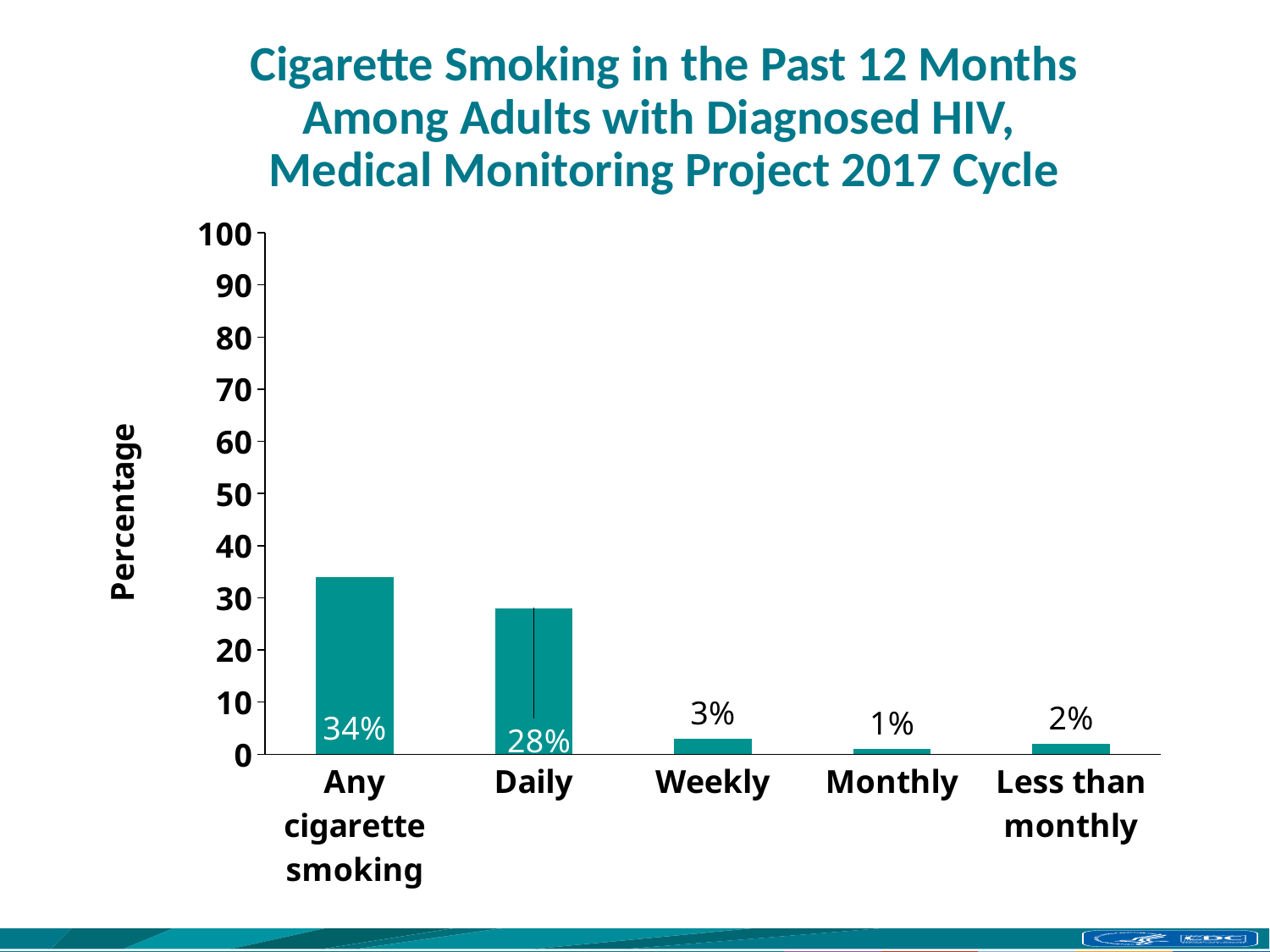
What is the difference in percentage points between Any cigarette smoking and Daily? 6 What percentage is shown for Daily cigarette smoking? 28% Which category has the highest percentage? Any cigarette smoking What percentage is shown for Less than monthly cigarette smoking? 2% What percentage is shown for Monthly cigarette smoking? 1% Which is larger, the percentage for Weekly or for Less than monthly? Weekly How many categories are shown on the x axis? 5 What percentage is shown for Any cigarette smoking? 34% Which category has the lowest percentage? Monthly What kind of chart is shown on the slide? Bar chart Is the value for Any cigarette smoking greater or less than 40? less What percentage is shown for Weekly cigarette smoking? 3%